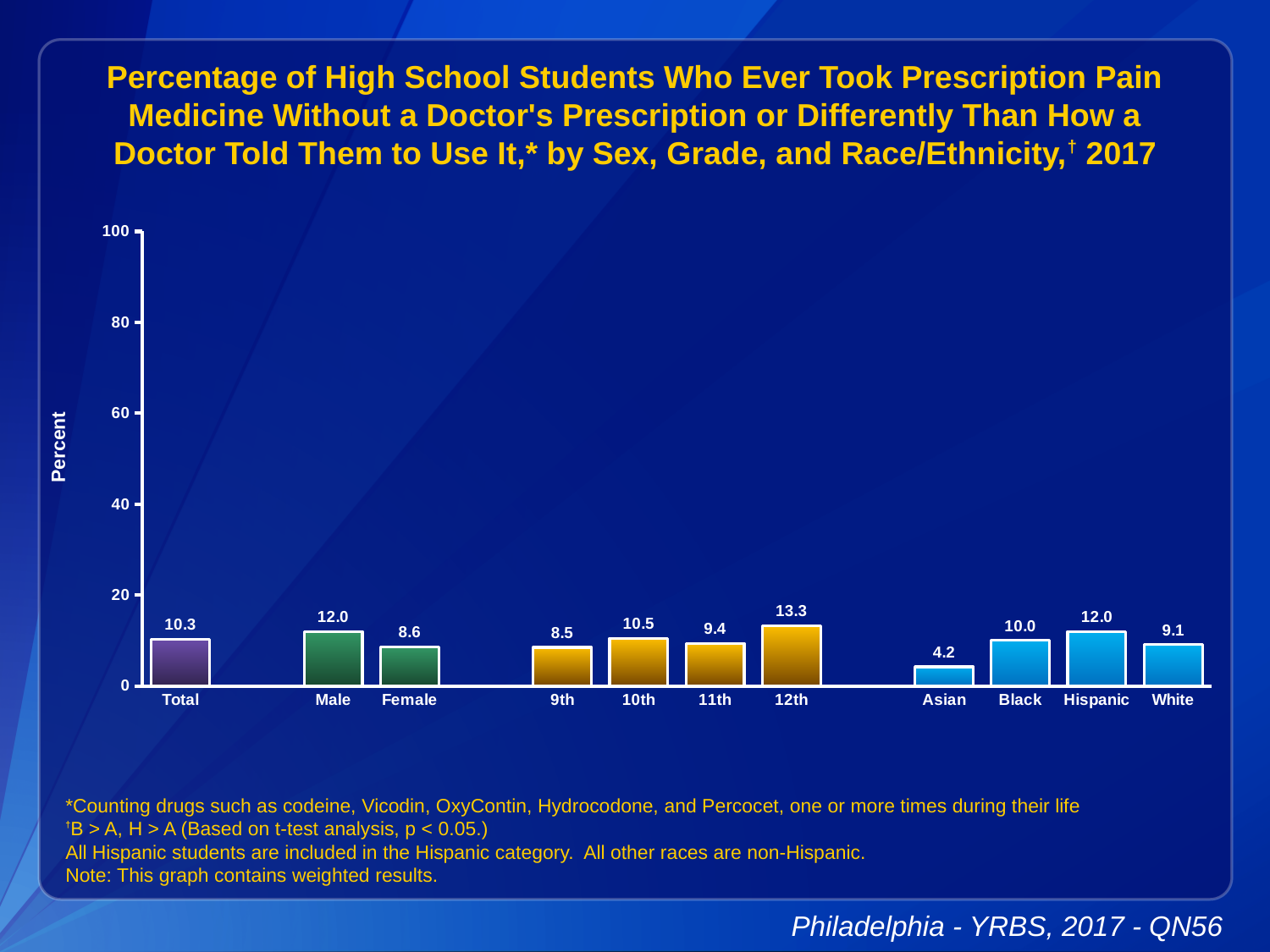
What is the value for Female? 8.6 What kind of chart is shown on the slide? bar chart What is the value for Asian students? 4.2 What is the difference between the Male and Female values? 3.4 Is the value for Black students greater or less than 20? less Which is larger, the value for 10th grade or 11th grade? 10th What is the value for 12th grade? 13.3 Which category has the lowest value? Asian What is the value for Total? 10.3 What is the label of the y axis? Percent Which category has the highest value? 12th How many bars are shown in the chart? 11